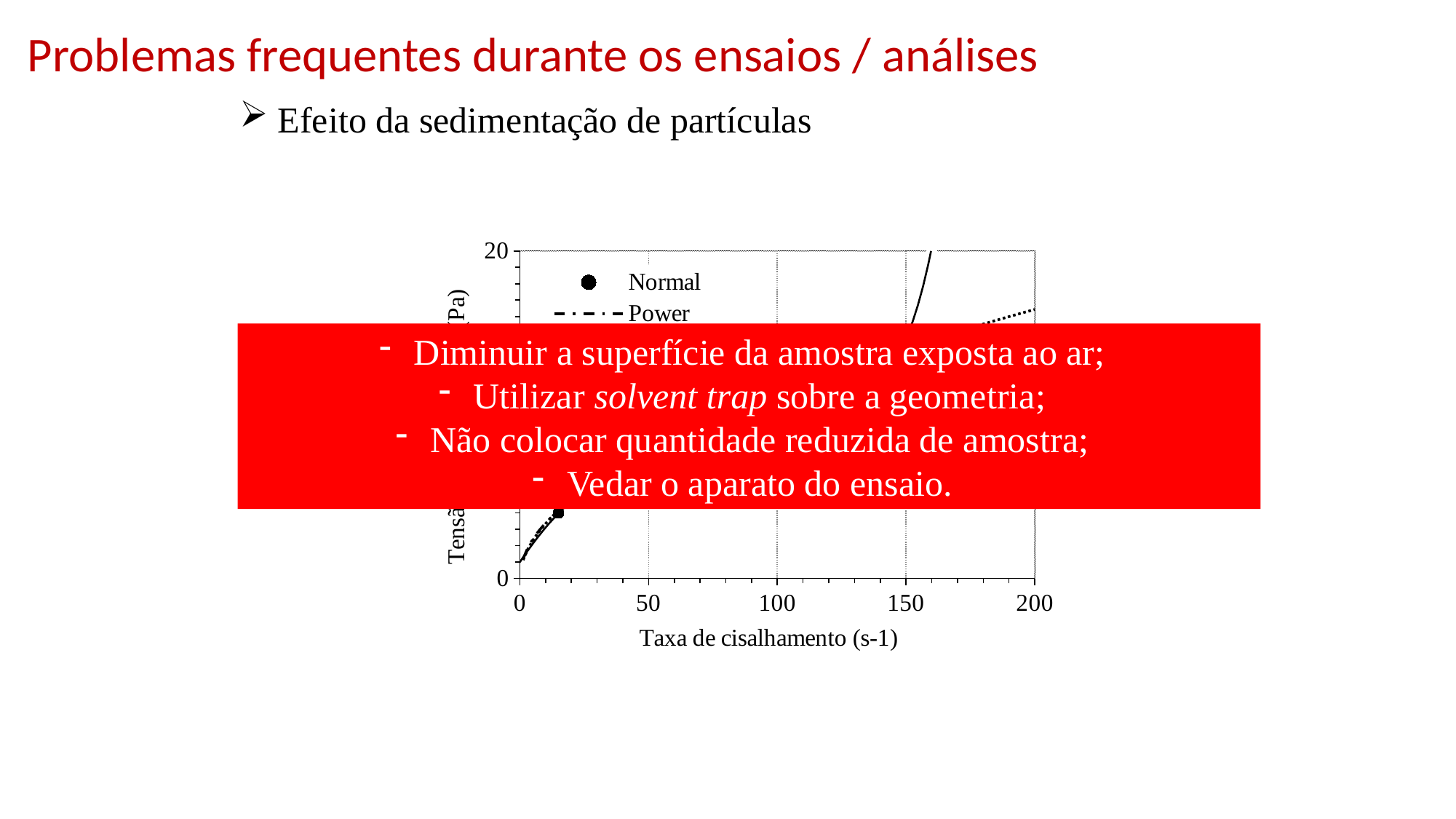
Which legend entry is shown with a dash-dot line style? Power What is the highest value labelled on the x axis of the chart? 200 Do the plotted values rise or fall as the shear rate (Taxa de cisalhamento) increases? rise What kind of chart is shown on the slide? line chart What is the highest value labelled on the y axis of the chart? 20 What is the label of the x axis of the chart? Taxa de cisalhamento (s-1) Is the value of the Normal data point near a shear rate of 15 s-1 greater or less than 20? less